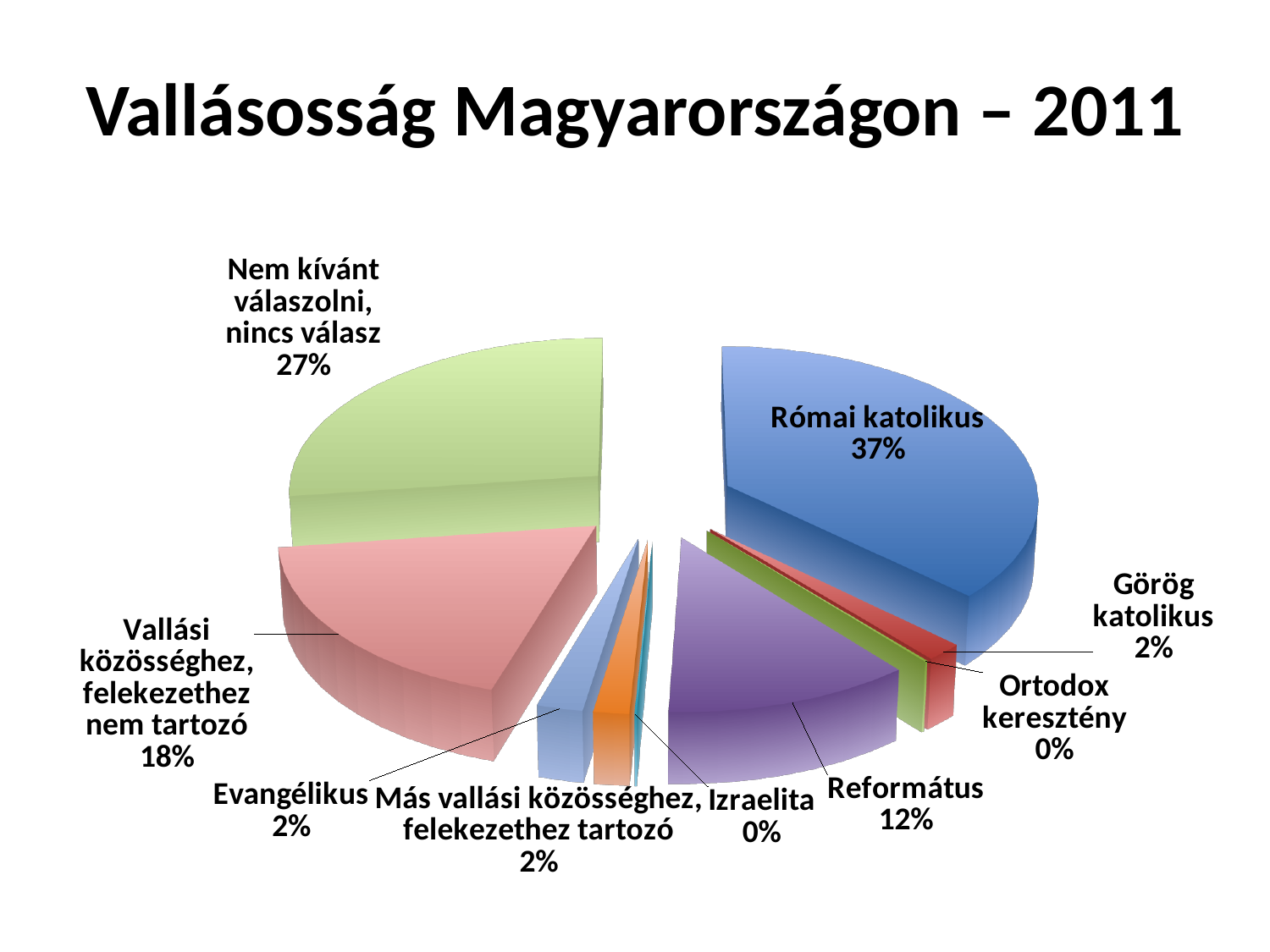
What share of the pie is labelled Görög katolikus? 2% What is the title of the slide? Vallásosság Magyarországon – 2011 How many categories (slices) are labelled on the pie chart? 9 Which is larger, the share for 'Nem kívánt válaszolni, nincs válasz' or the share for 'Vallási közösséghez, felekezethez nem tartozó'? Nem kívánt válaszolni, nincs válasz What is the combined share of Római katolikus and Görög katolikus? 39% What is the difference between the shares of Római katolikus and Református? 25% What kind of chart is shown on the slide? Pie chart What share of the pie is labelled Református? 12% What share of the pie is labelled 'Vallási közösséghez, felekezethez nem tartozó'? 18% What share of the pie is labelled 'Nem kívánt válaszolni, nincs válasz'? 27% Which category has the largest share of the pie? Római katolikus What share of the pie is labelled Római katolikus? 37%